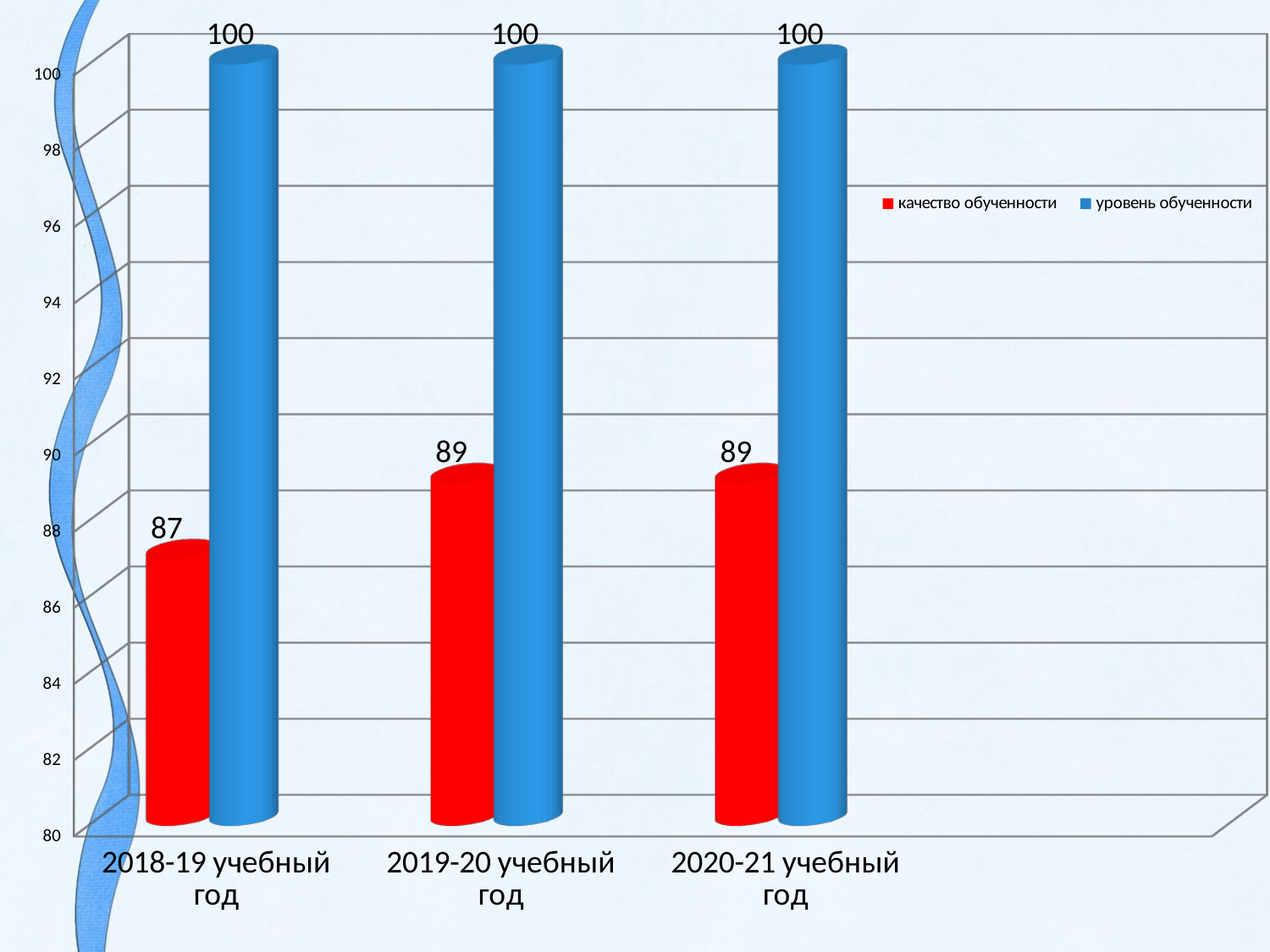
What is the value of качество обученности for 2018-19 учебный год? 87 What is the value of уровень обученности for 2019-20 учебный год? 100 Which is larger in 2020-21 учебный год: качество обученности or уровень обученности? уровень обученности What is the difference between уровень обученности and качество обученности in 2018-19 учебный год? 13 How many school years are shown on the x axis? 3 Does the value of качество обученности rise or fall from 2018-19 учебный год to 2019-20 учебный год? rise What is the difference between качество обученности in 2019-20 учебный год and 2018-19 учебный год? 2 What kind of chart is shown on the slide? bar chart How many series does the legend list? 2 Is the value of качество обученности for 2018-19 учебный год greater or less than 90? less Which school year has the lowest value for качество обученности? 2018-19 учебный год What is the value of качество обученности for 2020-21 учебный год? 89